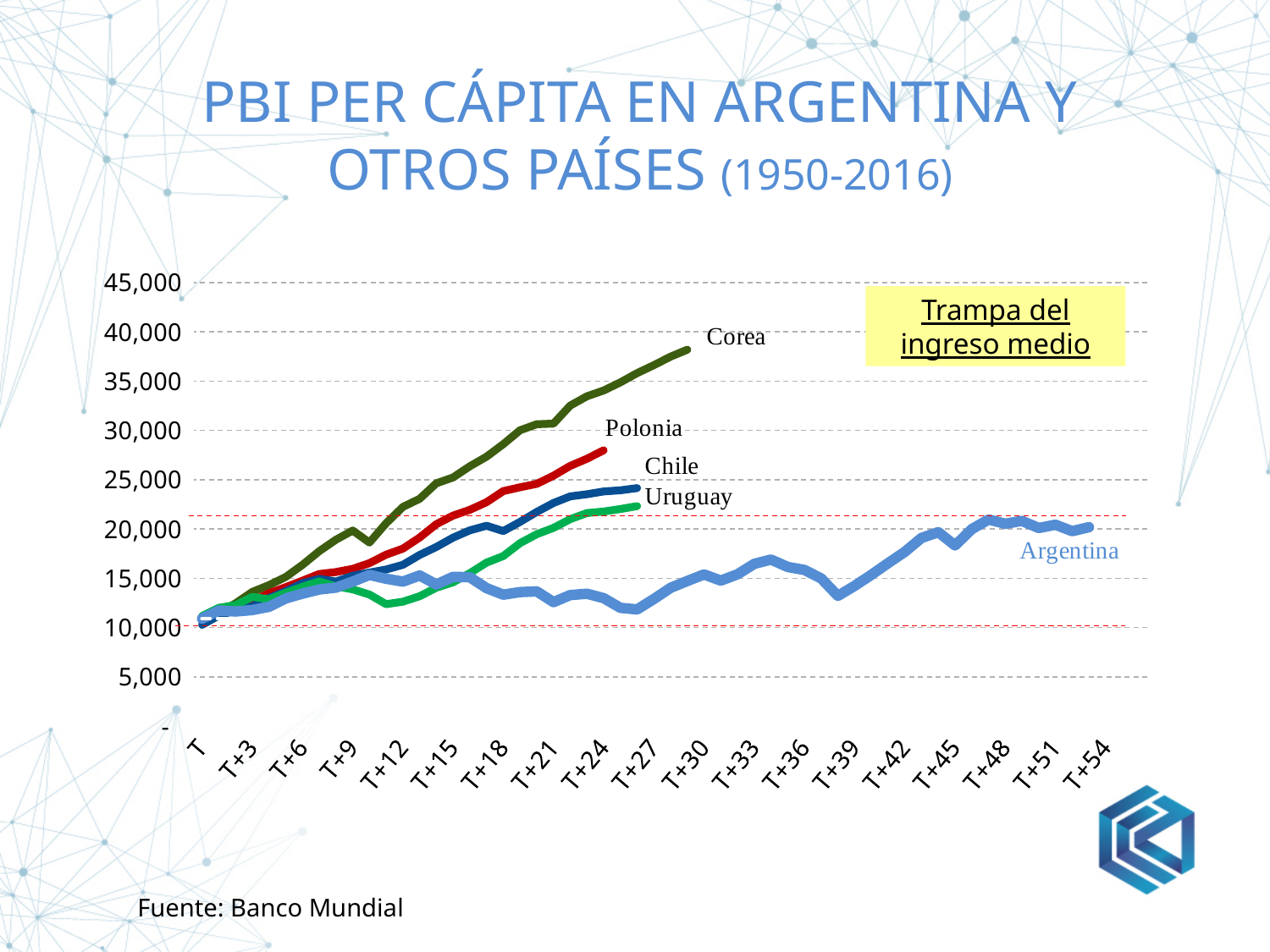
Does the Corea line generally rise or fall along the x axis? rise How many countries (series) are plotted in the chart? 5 Is the final value of the Argentina line greater or less than 25,000? less What kind of chart is shown on the slide? line chart Is the final value of the Chile line greater or less than 20,000? greater Which country's line reaches the highest value in the chart? Corea Is the final value of the Polonia line greater or less than 25,000? greater What source is cited for the chart data? Banco Mundial What is the title of the chart on the slide? PBI PER CÁPITA EN ARGENTINA Y OTROS PAÍSES (1950-2016) Which line ends at a higher value, Corea or Polonia? Corea